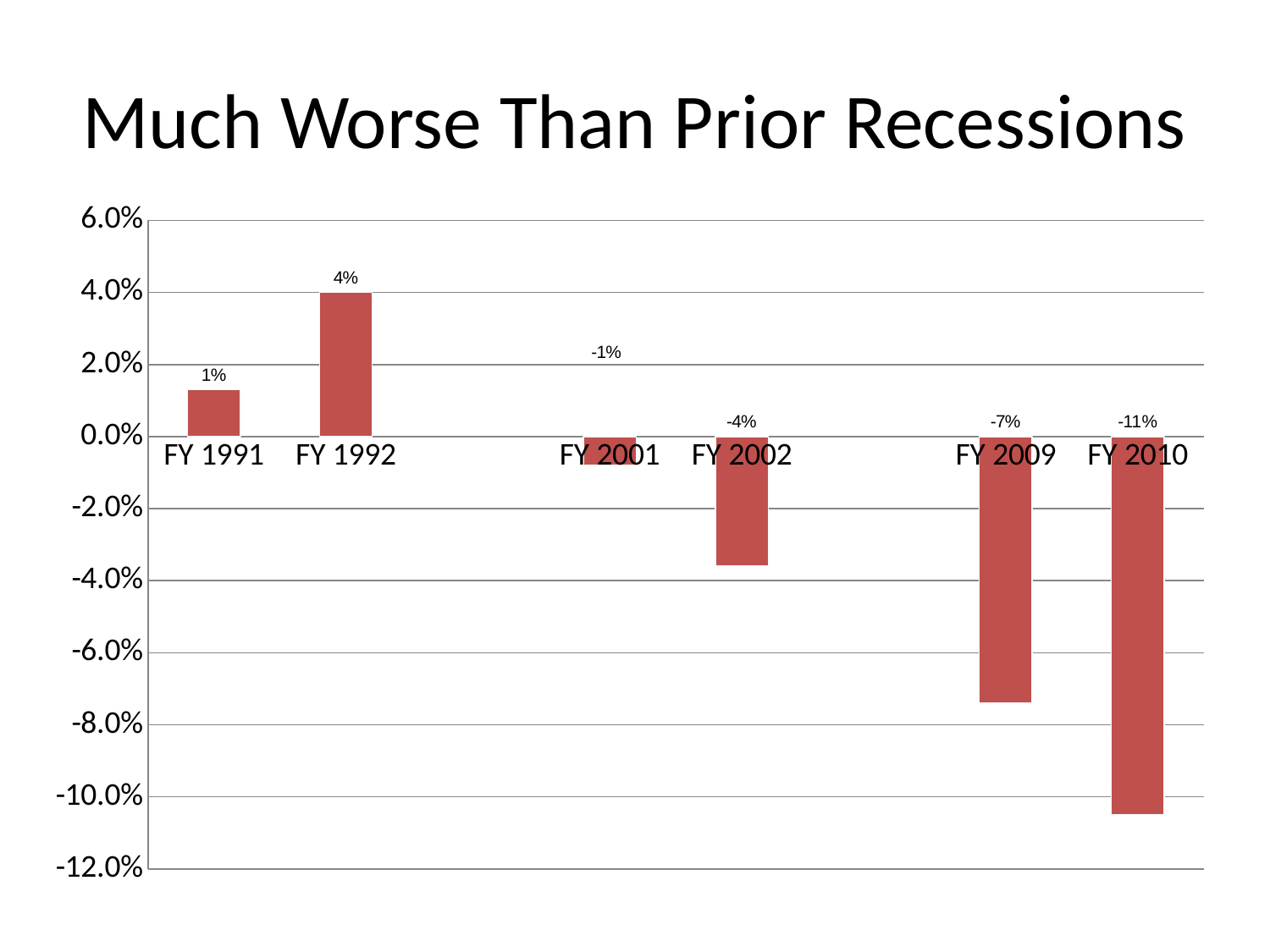
What is the data label shown for FY 2009? -7% How many fiscal years are plotted on the chart? 6 Is the value for FY 2010 greater or less than -10.0%? less What is the data label shown for FY 1992? 4% Is the value for FY 2009 greater or less than -8.0%? greater Which is larger, the value for FY 2001 or the value for FY 2009? FY 2001 What is the data label shown for FY 2002? -4% What is the data label shown for FY 2010? -11% Which fiscal year has the lowest value on the chart? FY 2010 What kind of chart is shown on the slide? Bar chart What is the title of the slide? Much Worse Than Prior Recessions Which fiscal year has the highest value on the chart? FY 1992